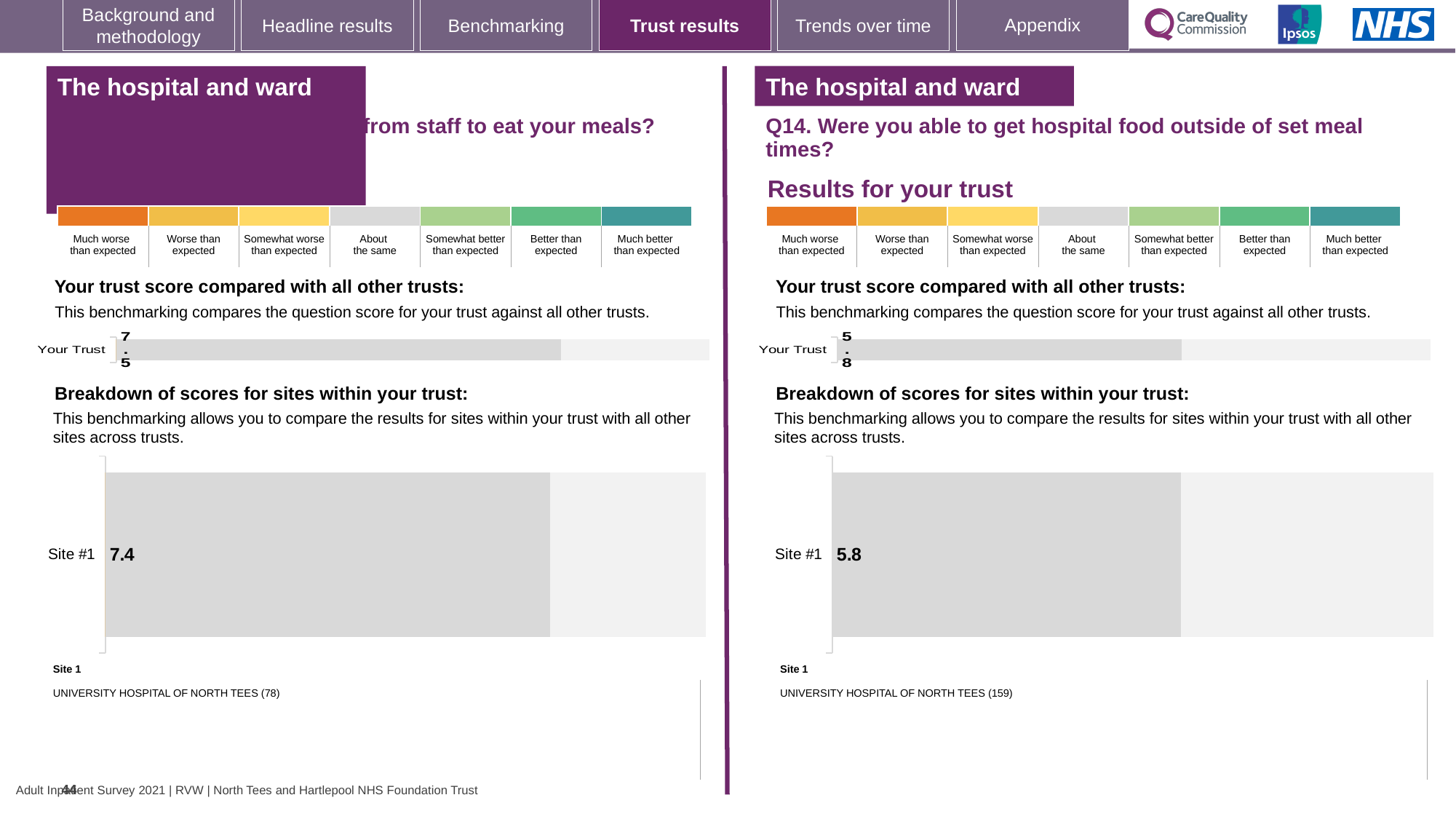
On the left-hand side of the slide, what score is shown for Site #1 in the 'Breakdown of scores for sites within your trust' chart? 7.4 On the left-hand side of the slide, what is the difference between the Your Trust score and the Site #1 score? 0.1 Which site is listed as Site 1 under the right-hand 'Breakdown of scores for sites within your trust' chart? UNIVERSITY HOSPITAL OF NORTH TEES (159) On the left-hand side of the slide, what is the value shown for Your Trust in the 'Your trust score compared with all other trusts' chart? 7.5 On the right-hand side of the slide (Q14), what score is shown for Site #1 in the 'Breakdown of scores for sites within your trust' chart? 5.8 What type of chart is used to show the Site #1 score on the left-hand side of the slide? Bar chart How many sites are shown in the right-hand 'Breakdown of scores for sites within your trust' chart? 1 On the right-hand side of the slide (Q14), what is the value shown for Your Trust in the 'Your trust score compared with all other trusts' chart? 5.8 Which is larger: the Site #1 score in the left-hand 'Breakdown of scores for sites' chart or the Site #1 score in the right-hand 'Breakdown of scores for sites' chart? The left-hand chart (7.4) What is the question text shown above the right-hand charts? Q14. Were you able to get hospital food outside of set meal times? What is the difference between the Your Trust score on the left-hand side of the slide (7.5) and the Your Trust score on the right-hand side (5.8)? 1.7